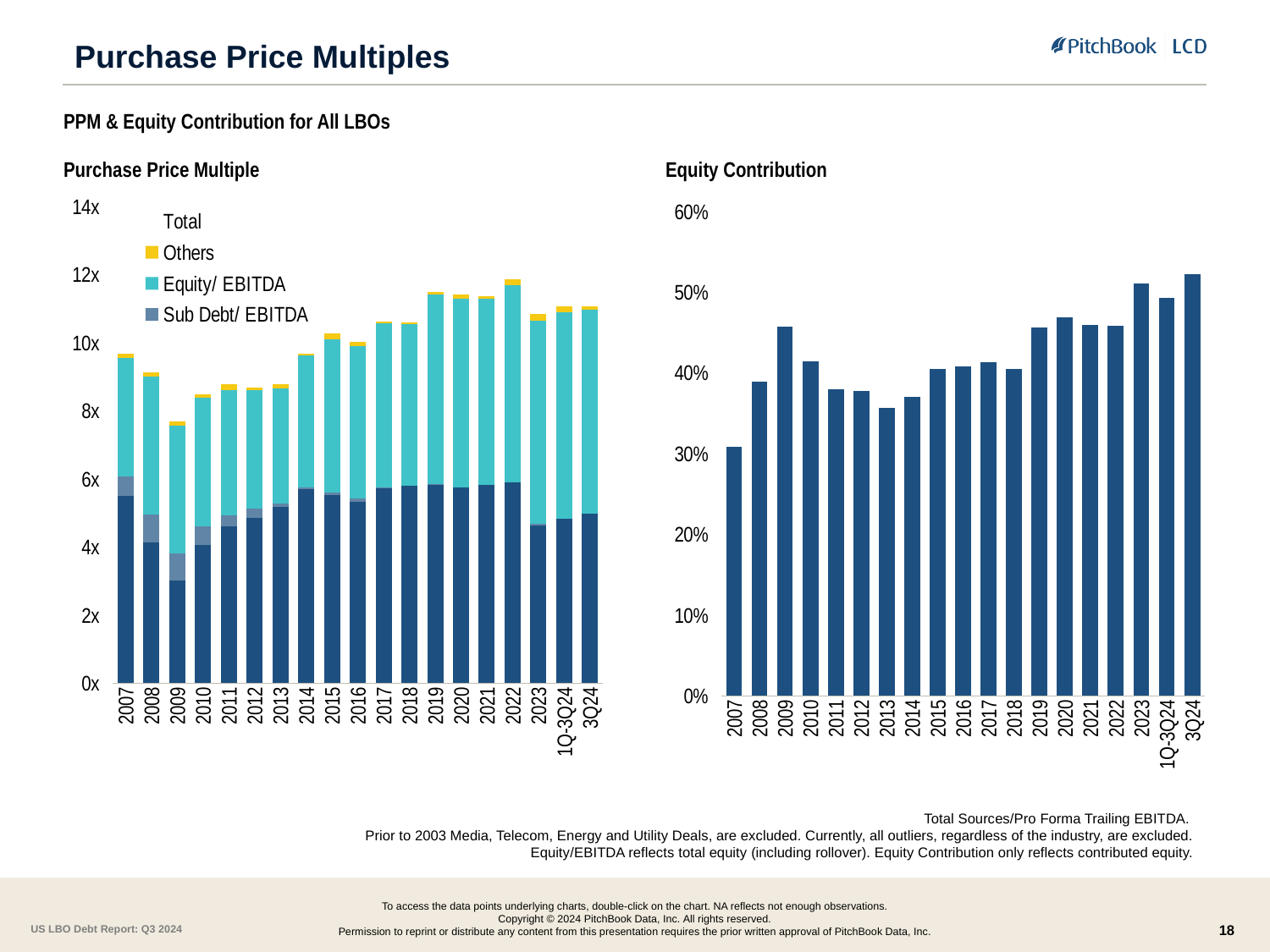
In the Equity Contribution chart, is the value for 2013 greater or less than 40%? less In the Equity Contribution chart, do the values generally rise or fall from 2013 to 2023? rise In the Purchase Price Multiple chart, is the total for 2009 greater or less than 8x? less In the Purchase Price Multiple chart, which legend entry is shown in yellow? Others How many categories are shown on the x axis of the Equity Contribution chart? 19 In the Equity Contribution chart, which year has the lowest equity contribution? 2007 In the Purchase Price Multiple chart, which year has the lowest total purchase price multiple? 2009 In the Purchase Price Multiple chart, is the total for 2019 greater or less than 10x? greater What type of chart is the Purchase Price Multiple chart? bar chart In the Purchase Price Multiple chart, which period has the highest total purchase price multiple? 2022 In the Equity Contribution chart, which is larger, the value for 2009 or the value for 2013? 2009